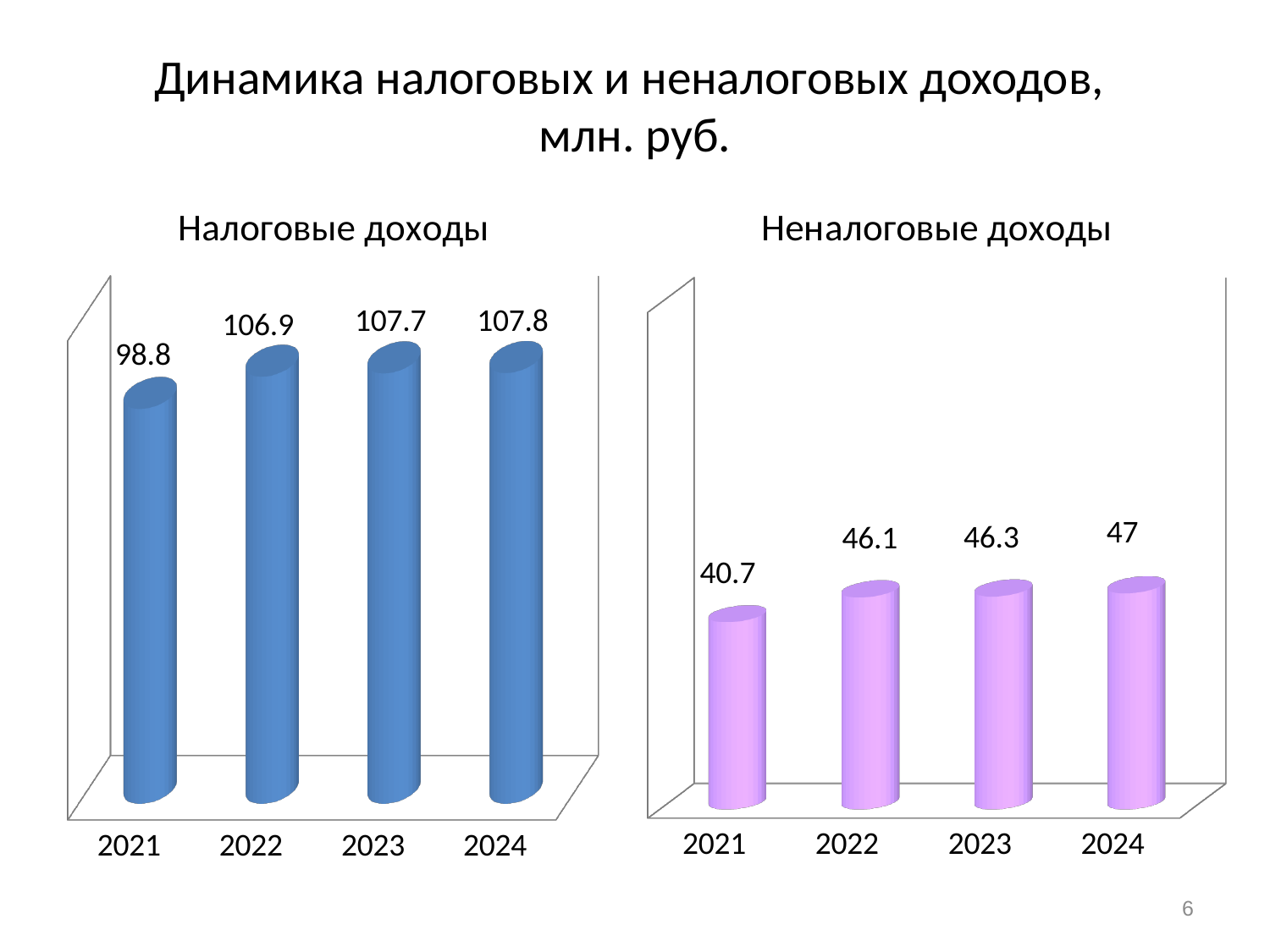
How many years are shown on the x axis of the 'Налоговые доходы' chart? 4 In the 'Налоговые доходы' chart, do the values rise or fall from 2021 to 2024? rise What kind of chart is the 'Неналоговые доходы' chart? bar chart In the 'Неналоговые доходы' chart, which is larger, the value for 2021 or the value for 2022? 2022 In the 'Налоговые доходы' chart, what is the difference between the values for 2022 and 2021? 8.1 In the 'Налоговые доходы' chart, what is the value for 2021? 98.8 In the 'Неналоговые доходы' chart, what is the value for 2022? 46.1 In the 'Неналоговые доходы' chart, which year has the highest value? 2024 In the 'Налоговые доходы' chart, which year has the lowest value? 2021 In the 'Неналоговые доходы' chart, what is the difference between the values for 2024 and 2021? 6.3 In the 'Неналоговые доходы' chart, what is the value for 2024? 47 In the 'Налоговые доходы' chart, what is the value for 2023? 107.7